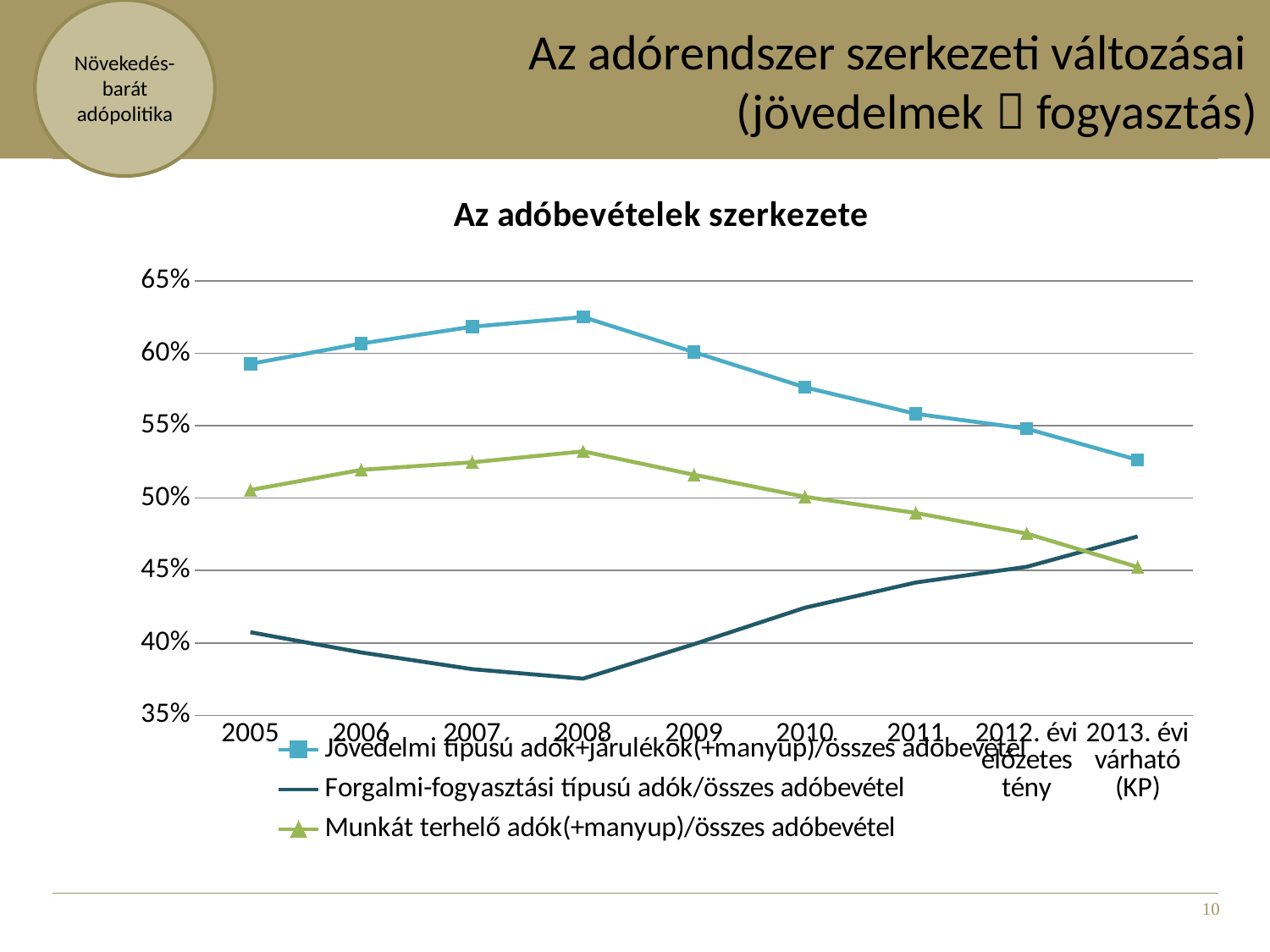
How many points (years/categories) are plotted along the x axis? 9 In which year does the series 'Jövedelmi típusú adók+járulékok(+manyup)/összes adóbevétel' reach its highest value? 2008 Is the 2008 value for 'Jövedelmi típusú adók+járulékok(+manyup)/összes adóbevétel' greater or less than 60%? greater In which year does the series 'Forgalmi-fogyasztási típusú adók/összes adóbevétel' reach its lowest value? 2008 In which category does the series 'Forgalmi-fogyasztási típusú adók/összes adóbevétel' reach its highest value? 2013. évi várható (KP) What is the title of the chart? Az adóbevételek szerkezete How many series does the legend list? 3 Is the 2008 value for 'Forgalmi-fogyasztási típusú adók/összes adóbevétel' greater or less than 40%? less Is the 2013. évi várható (KP) value for 'Munkát terhelő adók(+manyup)/összes adóbevétel' greater or less than 50%? less What kind of chart is shown on the slide? line chart Does the series 'Jövedelmi típusú adók+járulékok(+manyup)/összes adóbevétel' rise or fall from 2008 to 2013. évi várható (KP)? fall In 2013. évi várható (KP), which is larger: 'Forgalmi-fogyasztási típusú adók/összes adóbevétel' or 'Munkát terhelő adók(+manyup)/összes adóbevétel'? Forgalmi-fogyasztási típusú adók/összes adóbevétel